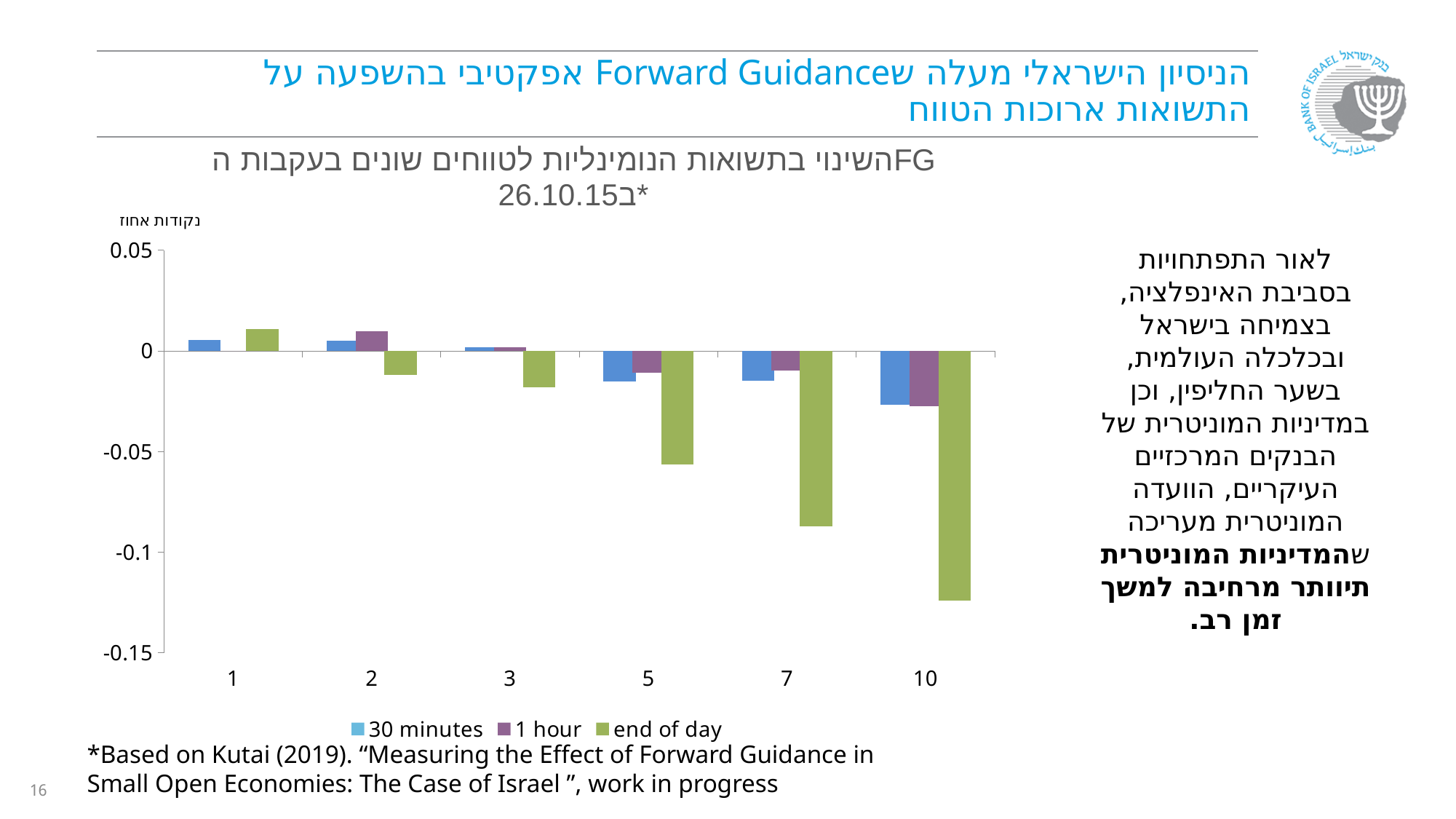
Which is larger, the 'end of day' value for category 2 or the 'end of day' value for category 10? category 2 What are the three series listed in the chart's legend? 30 minutes, 1 hour, end of day Is the 'end of day' value for category 7 greater or less than -0.05? less Which series has the lowest value at category 10? end of day Is the 'end of day' value for category 7 greater or less than -0.1? greater Do the 'end of day' values rise or fall as you move from category 2 to category 10 along the x axis? fall How many series does the chart's legend list? 3 Is the '30 minutes' value for category 1 greater or less than 0? greater How many categories are shown on the x axis of the chart? 6 What kind of chart is shown on the slide? bar chart Which category has the lowest 'end of day' value? 10